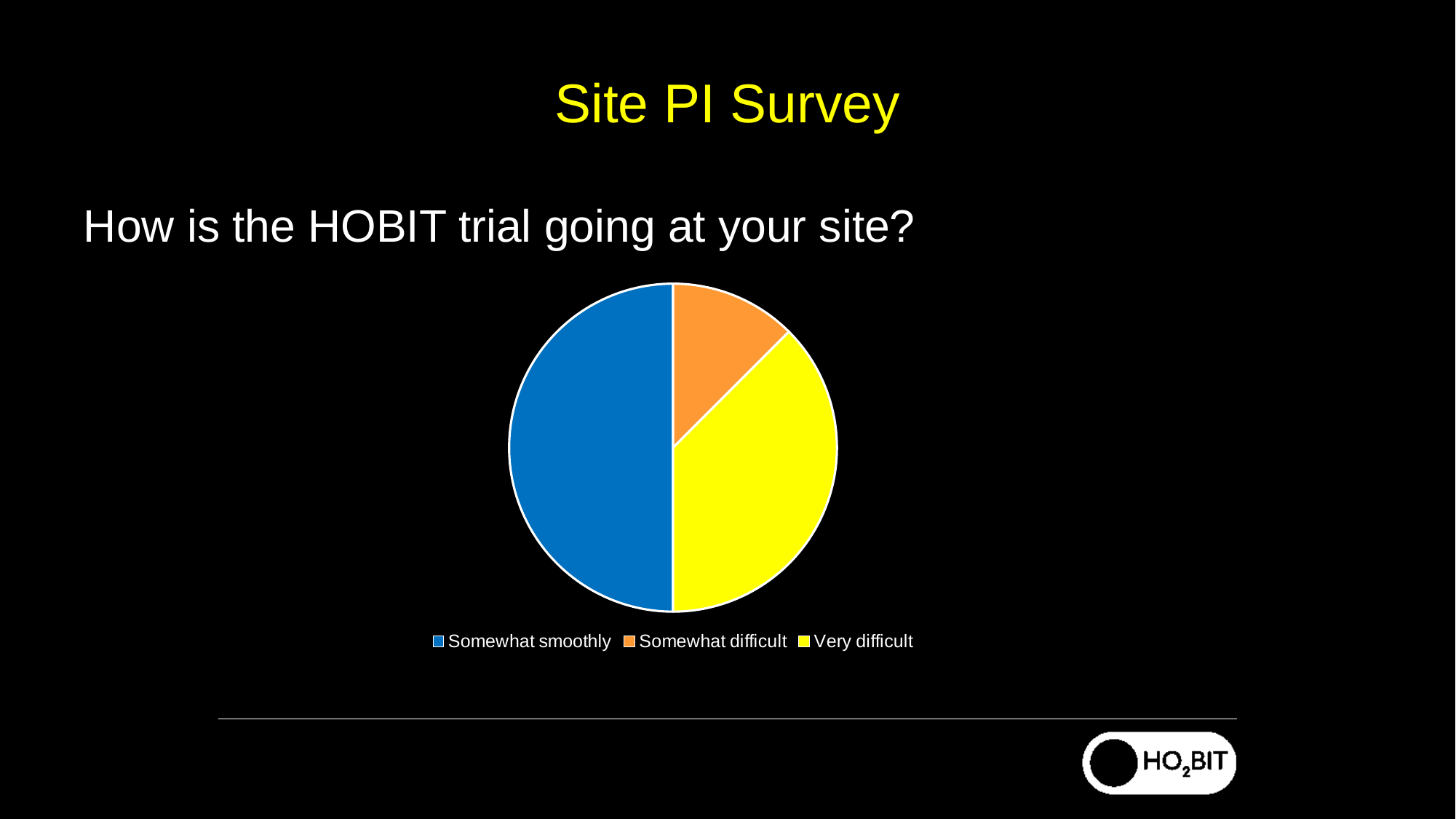
Which response category has the smallest slice of the pie chart? Somewhat difficult How many entries does the legend of the pie chart list? 3 Which slice is larger, Very difficult or Somewhat difficult? Very difficult Which slice is larger, Somewhat smoothly or Somewhat difficult? Somewhat smoothly What survey question is the pie chart answering? How is the HOBIT trial going at your site? What colour represents Very difficult in the pie chart? Yellow How many slices does the pie chart have? 3 Which slice is larger, Somewhat smoothly or Very difficult? Somewhat smoothly What kind of chart is shown on the slide? Pie chart Which response category has the largest slice of the pie chart? Somewhat smoothly